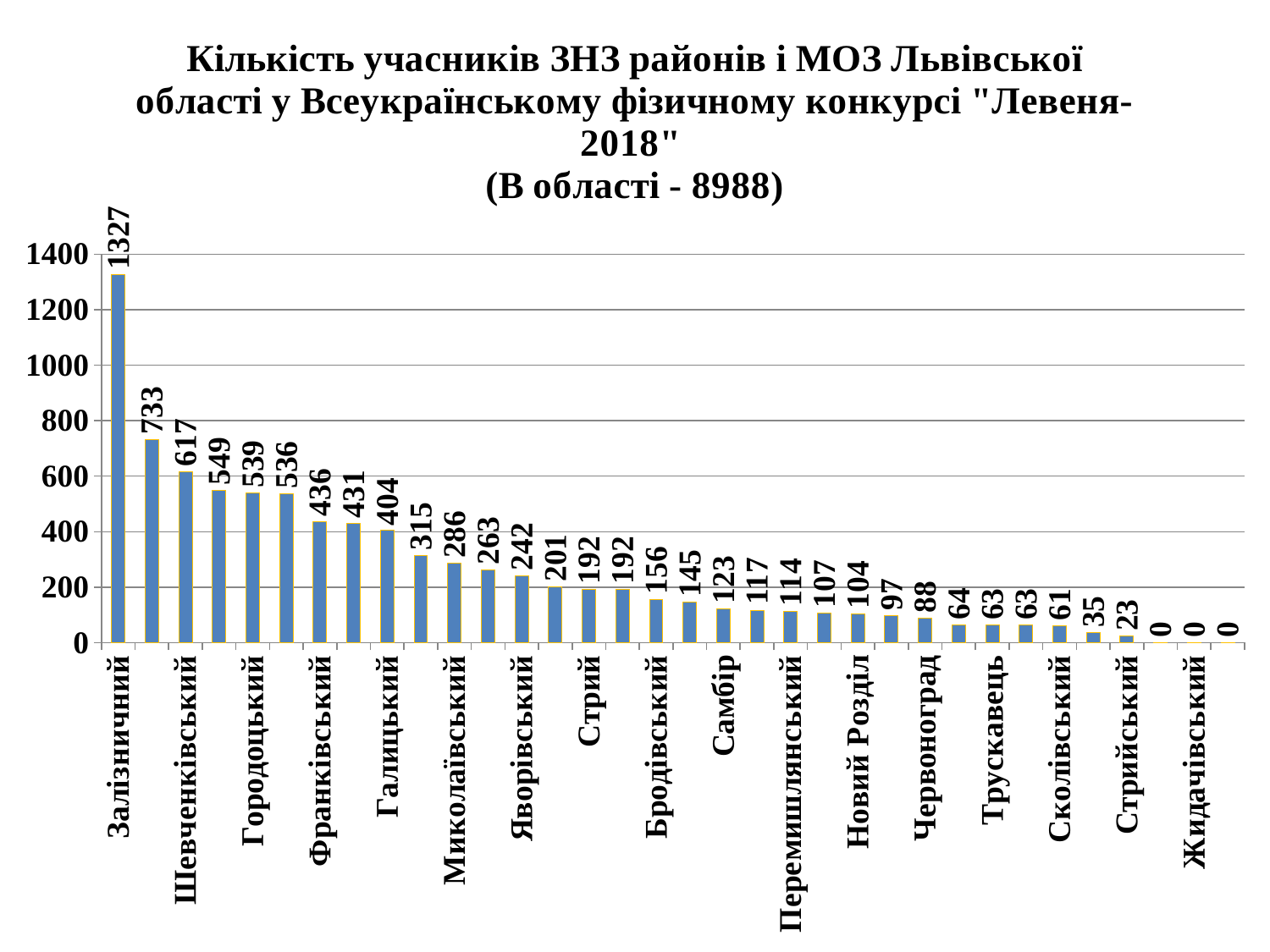
Which is larger, the value for Залізничний or the value for Шевченківський? Залізничний What is the value for Залізничний? 1327 What type of chart is shown on the slide? bar chart Is the value for Стрийський greater or less than 100? less Do the values rise or fall from left to right along the x axis? fall Which category has the highest number of participants? Залізничний How many bars are plotted in the chart? 34 Is the value for Городоцький greater or less than 600? less How many bars have a value of 0? 3 What is the difference between the highest bar (1327) and the second-highest bar (733)? 594 According to the chart title, what is the total number of participants in the region (В області)? 8988 What is the value for Жидачівський? 0